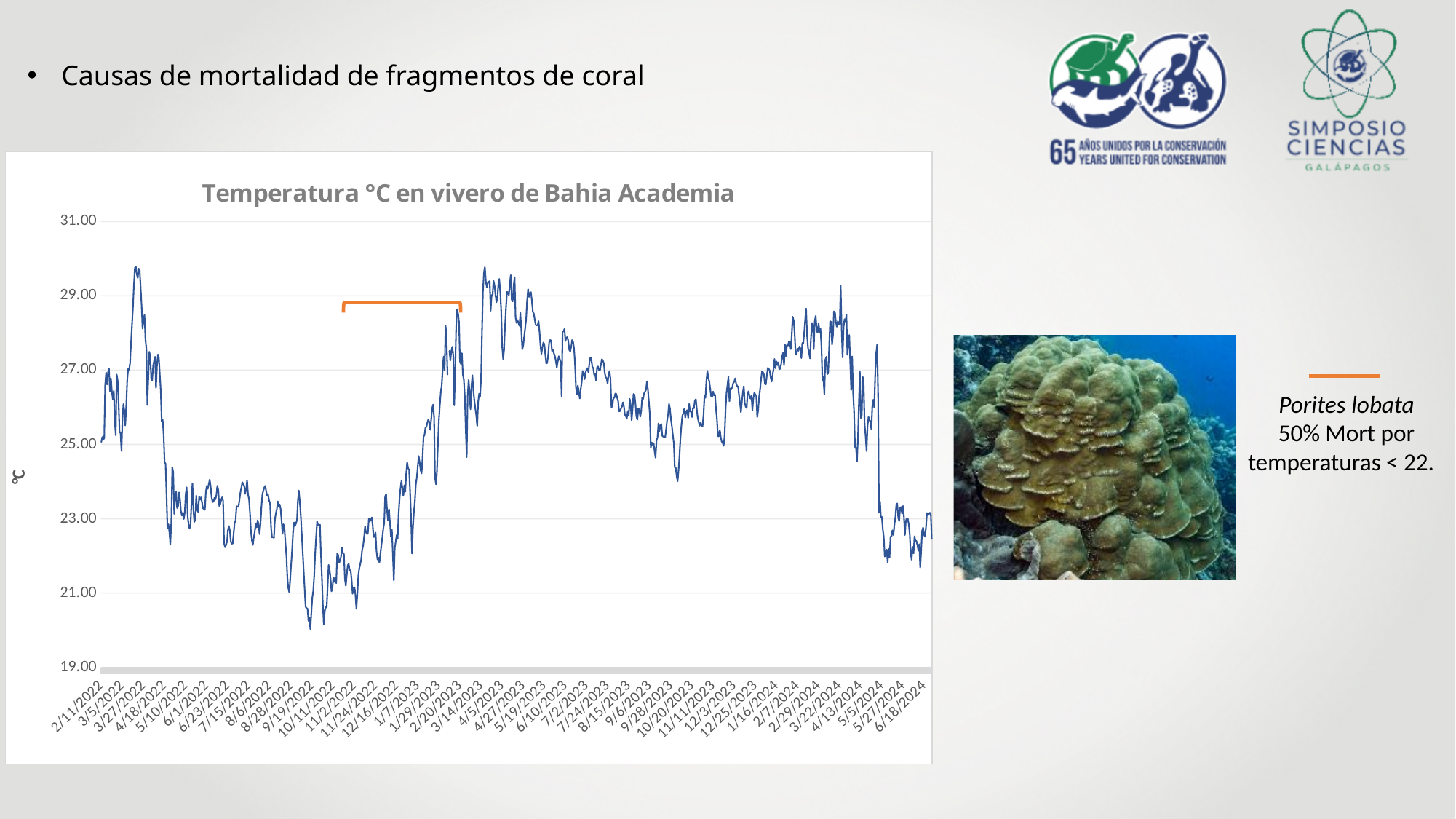
Does the temperature rise or fall between 10/11/2022 and 3/14/2023? rise What is the lowest tick value shown on the vertical axis? 19.00 What is the title of the chart? Temperatura °C en vivero de Bahia Academia What is the highest tick value shown on the vertical axis? 31.00 What is the first date shown on the horizontal axis? 2/11/2022 Is the highest temperature on the chart greater or less than 29.00? greater Which is higher, the temperature around 4/5/2023 or the temperature around 9/19/2022? 4/5/2023 Is the temperature at 6/18/2024 greater or less than 25.00? less What kind of chart is shown on the slide? line chart Is the lowest temperature on the chart greater or less than 21.00? less What is the last date shown on the horizontal axis? 6/18/2024 What is the label on the vertical axis of the chart? °C